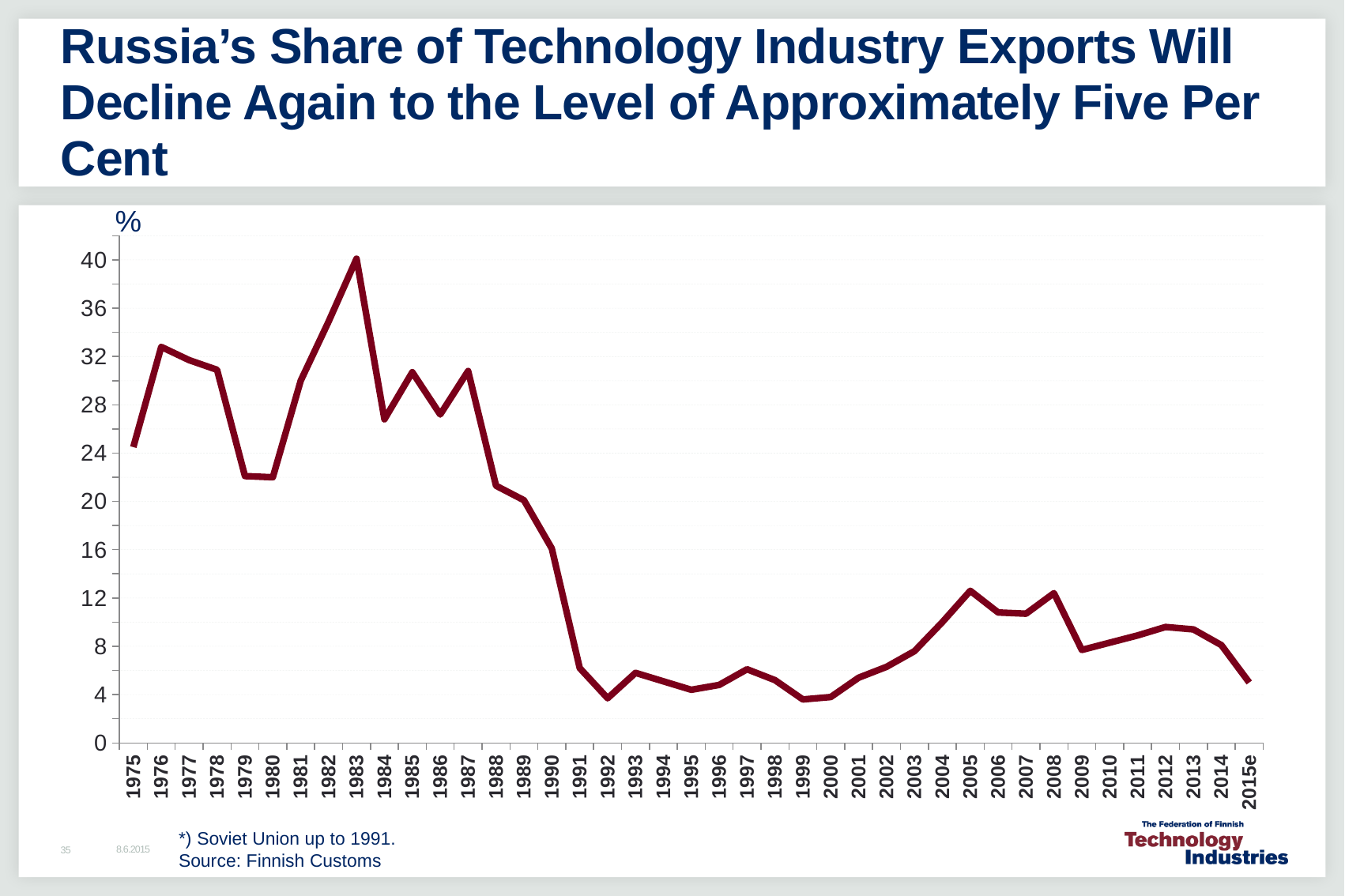
Is the value for 2015e greater or less than 8? less Is the value for 1975 greater or less than 20? greater Is the value for 1983 greater or less than 36? greater Does the share rise or fall between 1987 and 1992? fall What kind of chart is shown on the slide? line chart Which is larger, the value for 1983 or the value for 1985? 1983 Which is larger, the value for 2005 or the value for 2000? 2005 How many years (data points) are plotted on the x axis? 41 What unit is shown at the top of the y axis? % Which year has the highest share of technology industry exports to Russia? 1983